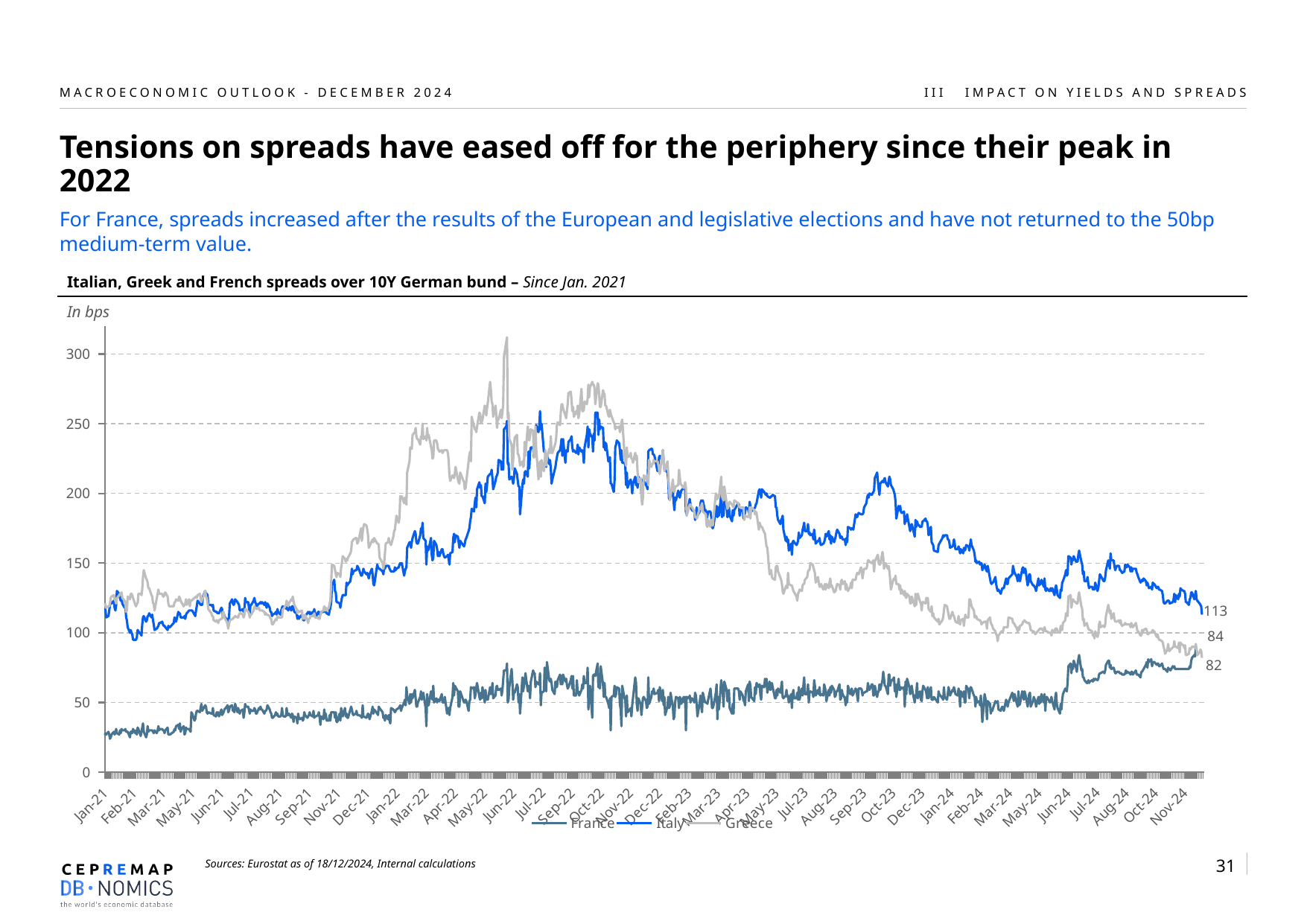
What is the latest value labelled for Italy at the right end of the chart? 113 What is the difference between the end-of-period values labelled for Italy and Greece? 29 In what unit are the values on the chart expressed? bps What kind of chart is shown on the slide? line chart What is the latest value labelled for France at the right end of the chart? 82 Which series reaches the highest peak over the whole period shown? Greece Does the France series rise or fall overall from Jan-21 to Nov-24? rise What is the latest value labelled for Greece at the right end of the chart? 84 What is the difference between the end-of-period values labelled for Italy and France? 31 How many series does the legend list? 3 Which series has the highest value at the right end of the chart? Italy Is the value for France in Jan-21 greater or less than 50? less